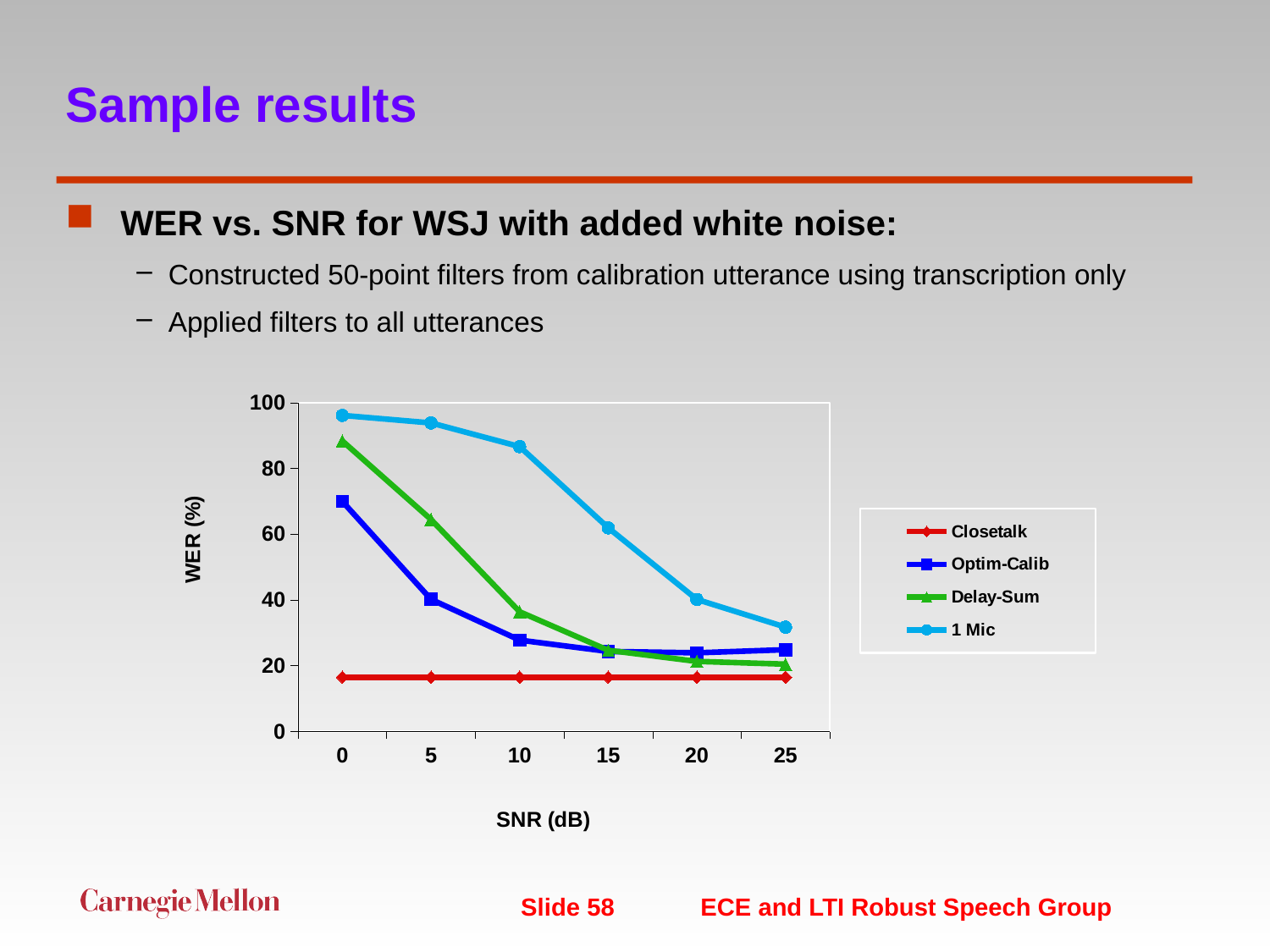
How many SNR values are plotted along the x axis? 6 At 5 dB SNR, which has the higher WER: Delay-Sum or Optim-Calib? Delay-Sum What kind of chart is shown on the slide? line chart Is the WER for 1 Mic at 0 dB SNR greater or less than 80? greater Is the WER for Closetalk at 25 dB SNR greater or less than 20? less Is the WER for Delay-Sum at 10 dB SNR greater or less than 60? less Which series has the lowest WER across all SNR values? Closetalk At 20 dB SNR, which series has the highest WER? 1 Mic Does the WER for 1 Mic rise or fall as SNR increases? falls How many series does the legend list? 4 What is the label on the y axis of the chart? WER (%)